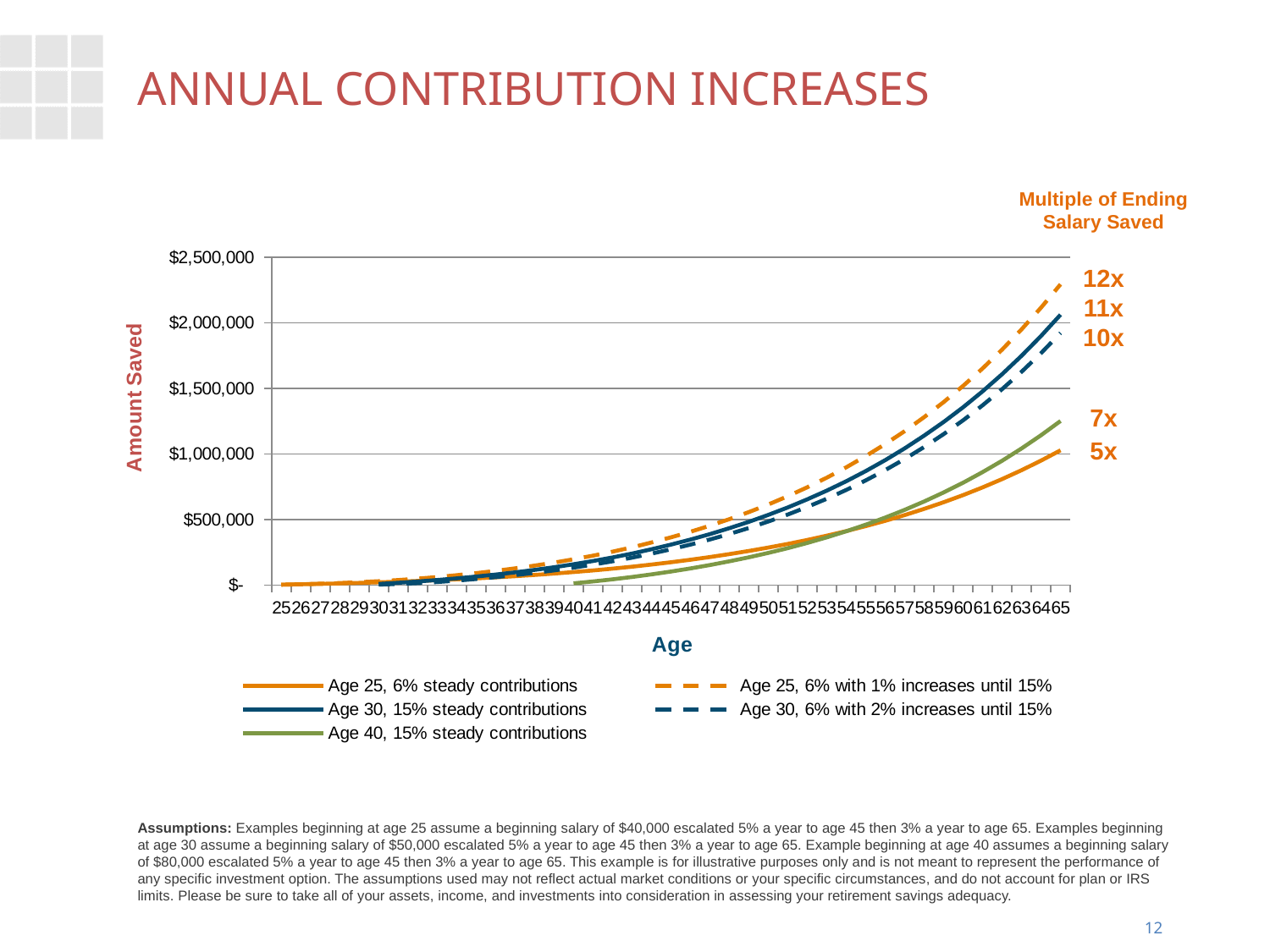
What kind of chart is shown on the slide? line chart What is the title of the chart? ANNUAL CONTRIBUTION INCREASES How many series does the legend list? 5 Which series has the lowest amount saved at age 65? Age 25, 6% steady contributions At age 65, which is larger: the amount saved for 'Age 40, 15% steady contributions' or for 'Age 25, 6% steady contributions'? Age 40, 15% steady contributions What multiple of ending salary saved is labelled for the highest line at age 65? 12x Is the amount saved at age 65 for 'Age 25, 6% with 1% increases until 15%' greater or less than $2,000,000? greater Is the amount saved at age 65 for 'Age 30, 15% steady contributions' greater or less than $1,500,000? greater Is the amount saved at age 65 for 'Age 40, 15% steady contributions' greater or less than $1,500,000? less What is the label on the vertical axis? Amount Saved Do the amounts saved rise or fall as age increases along the x axis? rise Which series has the highest amount saved at age 65? Age 25, 6% with 1% increases until 15%